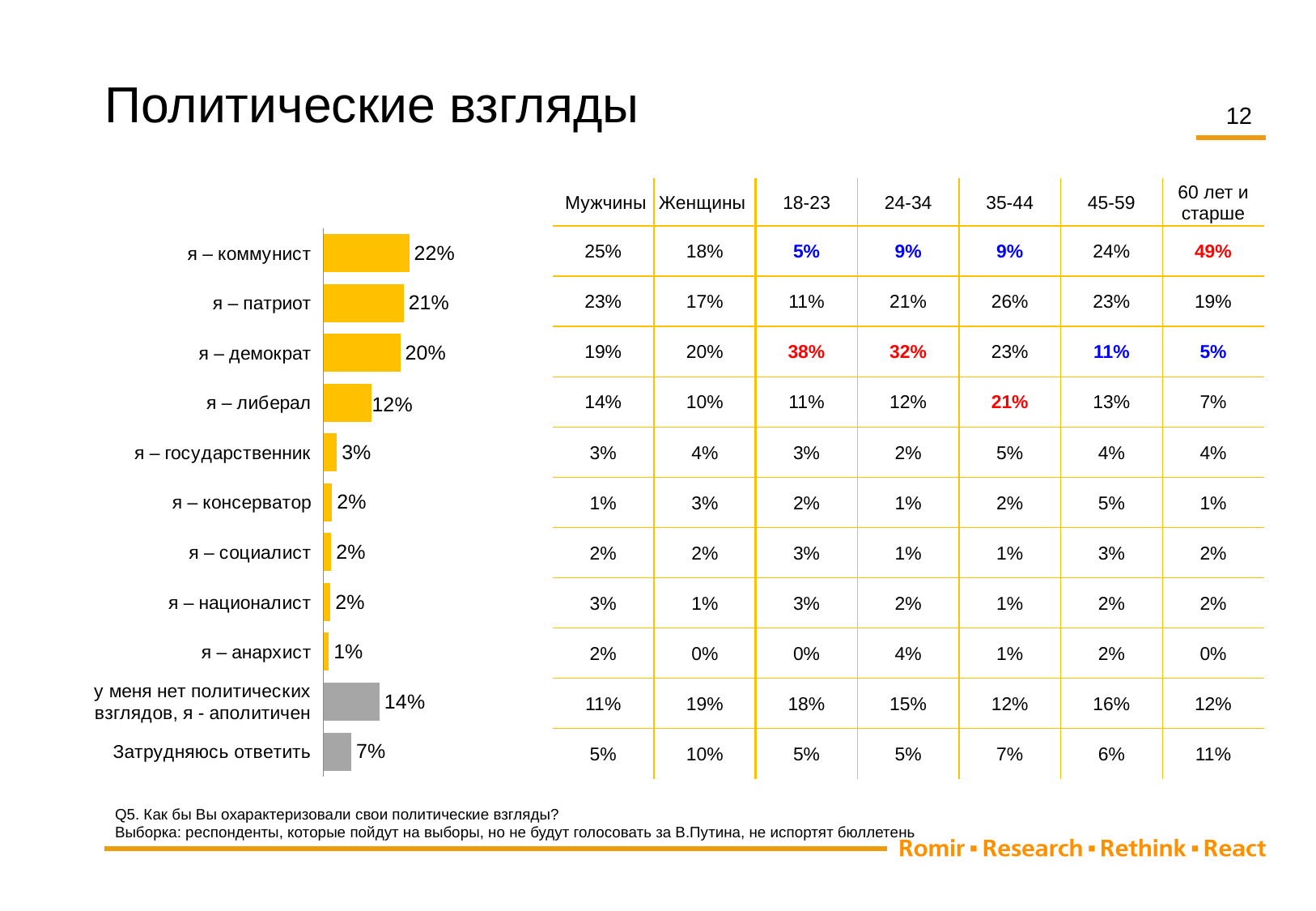
How many categories are shown in the bar chart? 11 Which is larger in the bar chart: the value for "я – либерал" or the value for "у меня нет политических взглядов, я - аполитичен"? у меня нет политических взглядов, я - аполитичен What is the difference between the values for "я – коммунист" and "я – демократ" in the bar chart? 2% What is the value for "я – коммунист" in the bar chart? 22% Which category has the lowest value in the bar chart? я – анархист Which category has the highest value in the bar chart? я – коммунист What is the difference between the values for "я – патриот" and "я – либерал" in the bar chart? 9% What is the value for "у меня нет политических взглядов, я - аполитичен" in the bar chart? 14% What colour are the bars for "у меня нет политических взглядов, я - аполитичен" and "Затрудняюсь ответить" in the bar chart? grey What type of chart is shown on the slide? bar chart What is the value for "я – либерал" in the bar chart? 12% What is the value for "Затрудняюсь ответить" in the bar chart? 7%